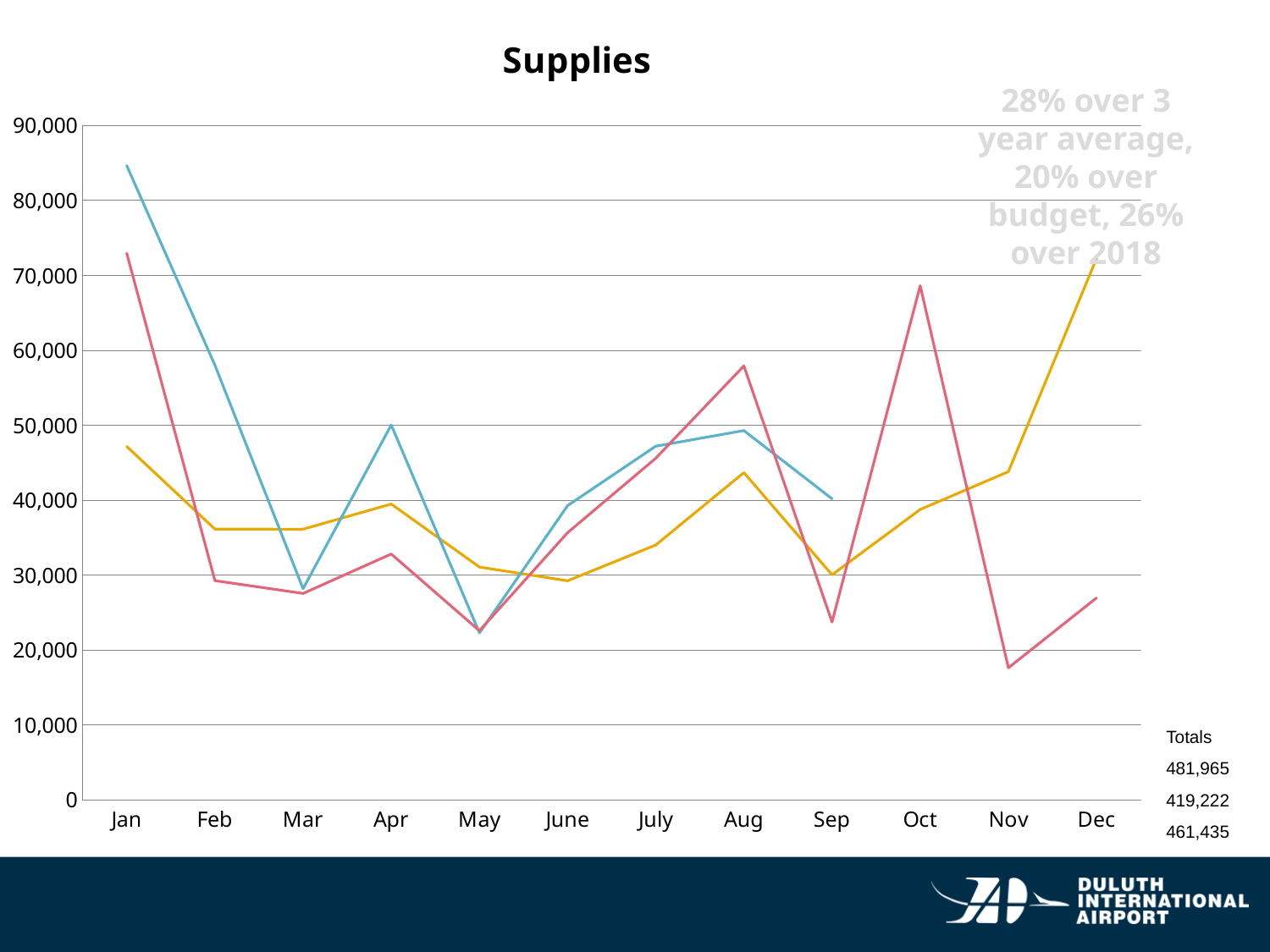
Is the value of the blue line in Jan greater or less than 80,000? greater What type of chart is shown on the slide? line chart Is the value of the pink line in Aug greater or less than 50,000? greater In which month does the pink line reach its highest value? Jan In Oct, which line has the higher value, the pink line or the yellow line? pink line Is the value of the yellow line in Dec greater or less than 60,000? greater What is the title of the chart? Supplies In which month does the pink line reach its lowest value? Nov How many months are shown on the x axis of the chart? 12 In which month does the yellow line reach its highest value? Dec What is the last month for which the blue line has a data point? Sep